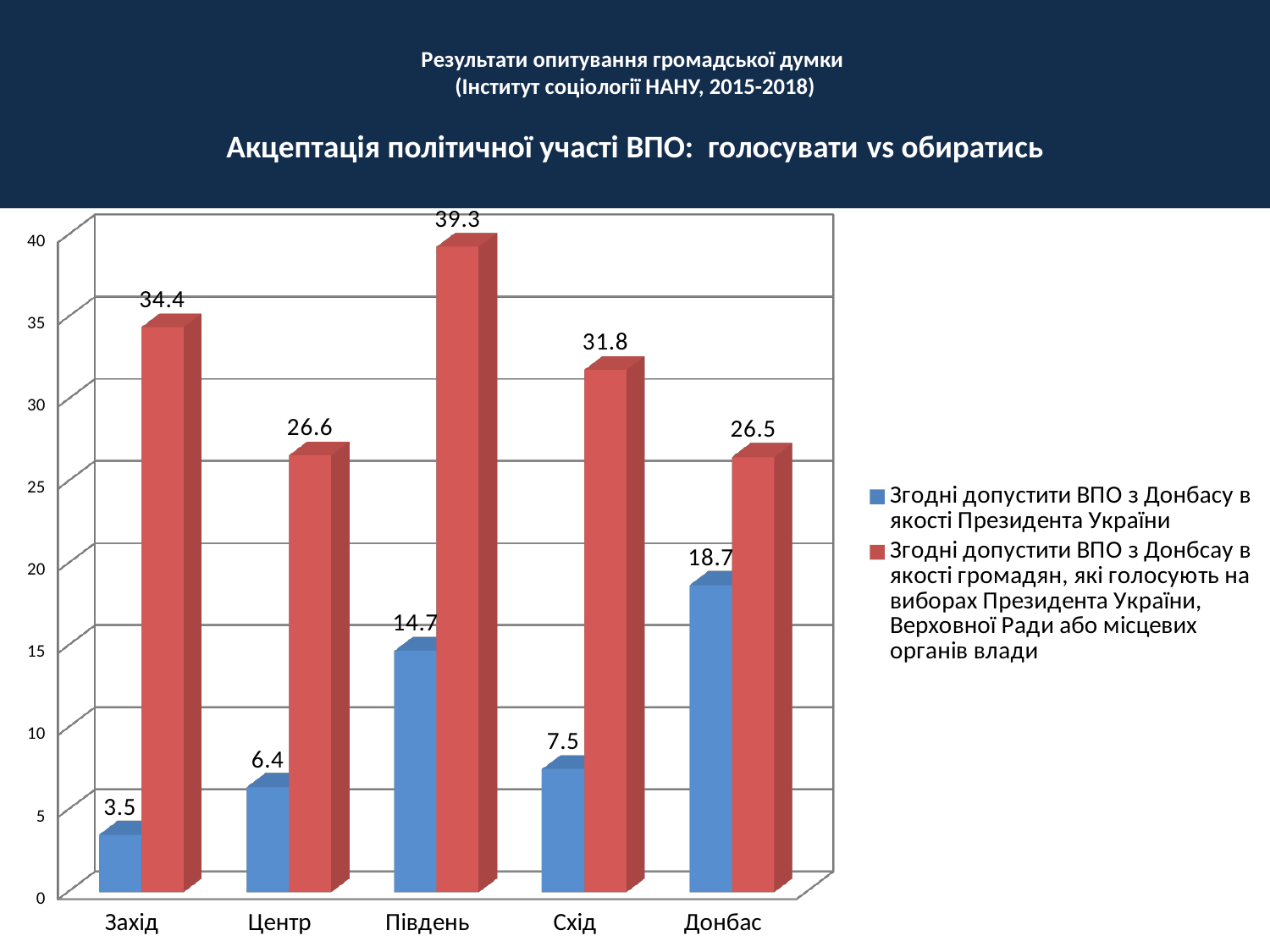
Which region has the highest value in the series "Згодні допустити ВПО з Донбсау в якості громадян, які голосують на виборах Президента України, Верховної Ради або місцевих органів влади"? Південь What kind of chart is shown on the slide? Bar chart Which region has the lowest value in the series "Згодні допустити ВПО з Донбасу в якості Президента України"? Захід Which is larger: the value for Центр or the value for Донбас in the series "Згодні допустити ВПО з Донбасу в якості Президента України"? Донбас What is the value for Донбас in the series "Згодні допустити ВПО з Донбасу в якості Президента України"? 18.7 What is the value for Захід in the series "Згодні допустити ВПО з Донбасу в якості Президента України"? 3.5 How many series does the legend list? 2 What is the value for Південь in the series "Згодні допустити ВПО з Донбсау в якості громадян, які голосують на виборах Президента України, Верховної Ради або місцевих органів влади"? 39.3 What is the difference between the two series' values for Схід? 24.3 What colour are the bars for the series "Згодні допустити ВПО з Донбасу в якості Президента України"? Blue What is the value for Центр in the series "Згодні допустити ВПО з Донбсау в якості громадян, які голосують на виборах Президента України, Верховної Ради або місцевих органів влади"? 26.6 How many regions are shown on the x axis? 5